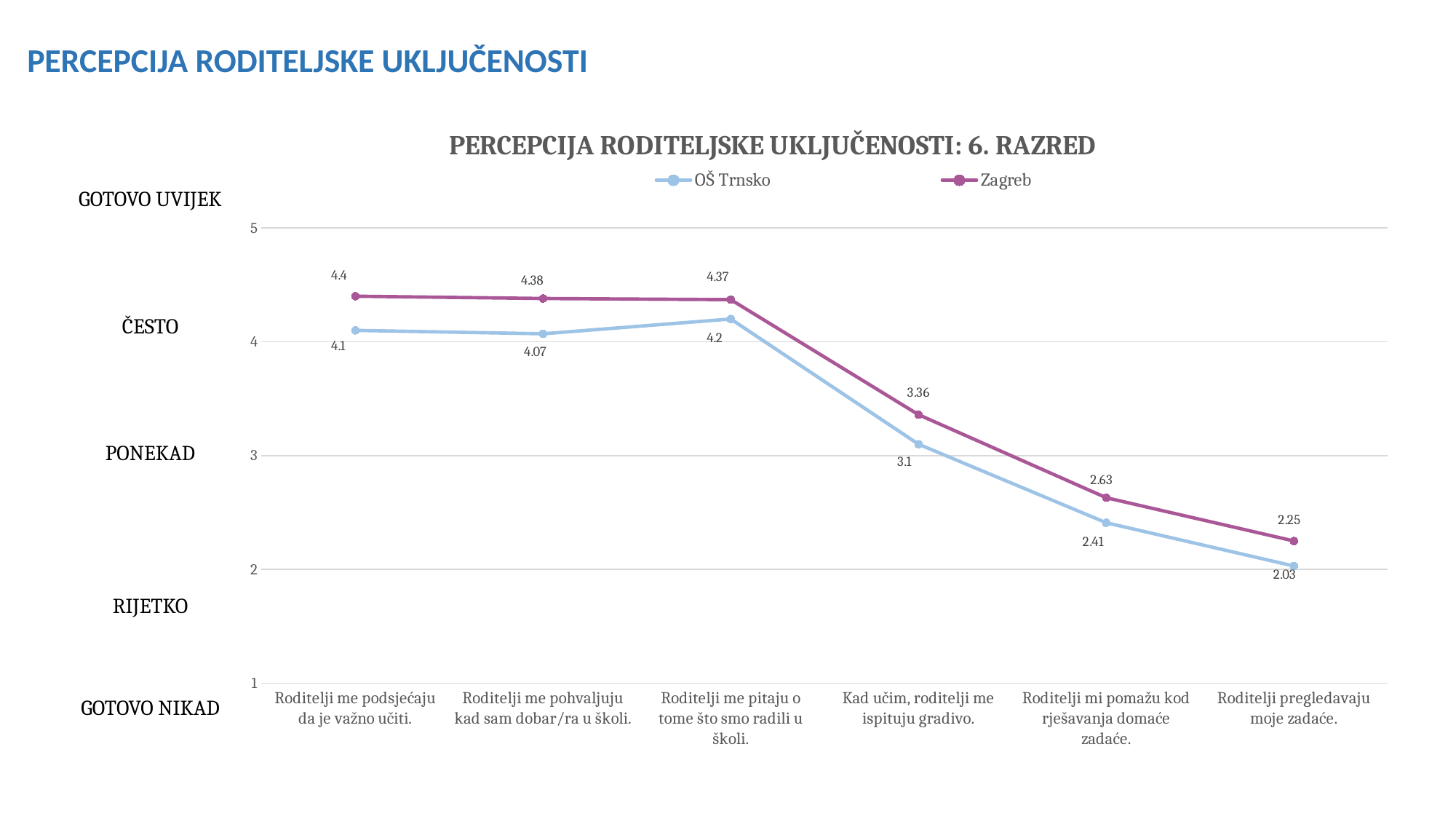
What is the difference between Zagreb and OŠ Trnsko for "Kad učim, roditelji me ispituju gradivo."? 0.26 How many series does the legend list? 2 What is the value for Zagreb for "Kad učim, roditelji me ispituju gradivo."? 3.36 What is the value for OŠ Trnsko for "Roditelji me podsjećaju da je važno učiti."? 4.1 Which category has the highest value for Zagreb? Roditelji me podsjećaju da je važno učiti. Which series has the larger value for "Roditelji me pohvaljuju kad sam dobar/ra u školi."? Zagreb How many categories are shown on the x axis? 6 What is the value for OŠ Trnsko for "Roditelji mi pomažu kod rješavanja domaće zadaće."? 2.41 Do the values for OŠ Trnsko rise or fall from "Roditelji me pitaju o tome što smo radili u školi." to "Roditelji pregledavaju moje zadaće."? Fall What is the value for Zagreb for "Roditelji pregledavaju moje zadaće."? 2.25 Which category has the lowest value for OŠ Trnsko? Roditelji pregledavaju moje zadaće. What kind of chart is this? Line chart